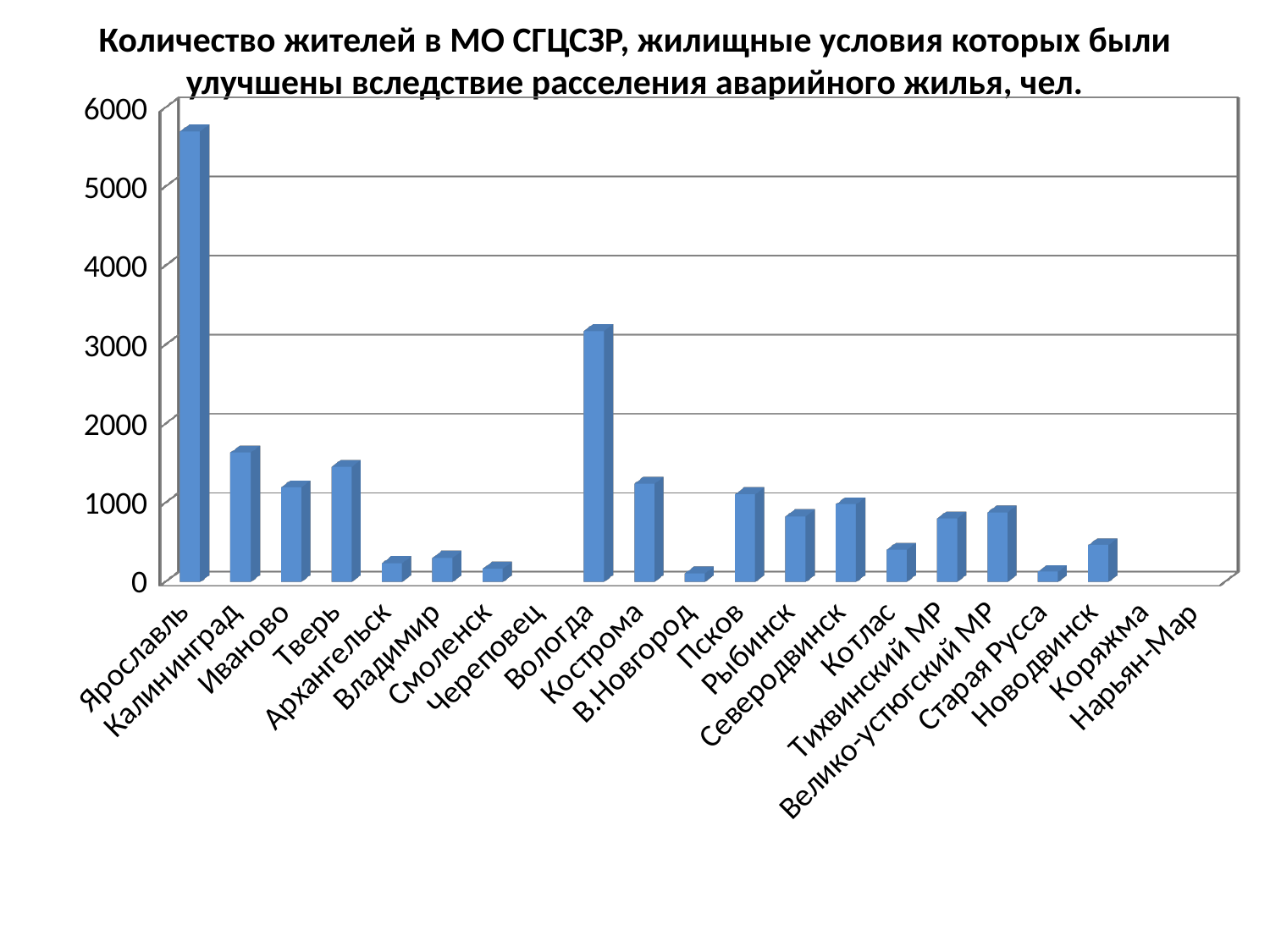
What is the maximum value shown on the vertical axis of the chart? 6000 Is the value for Архангельск greater or less than 1000? less Is the value for Котлас greater or less than 1000? less Which is larger, the value for Тверь or the value for Архангельск? Тверь How many categories are shown on the x axis of the chart? 21 Is the value for Ярославль greater or less than 5000? greater What kind of chart is shown on the slide? bar chart Which city has the highest number of residents whose housing conditions were improved? Ярославль Which is larger, the value for Вологда or the value for Калининград? Вологда Which is larger, the value for Ярославль or the value for Вологда? Ярославль